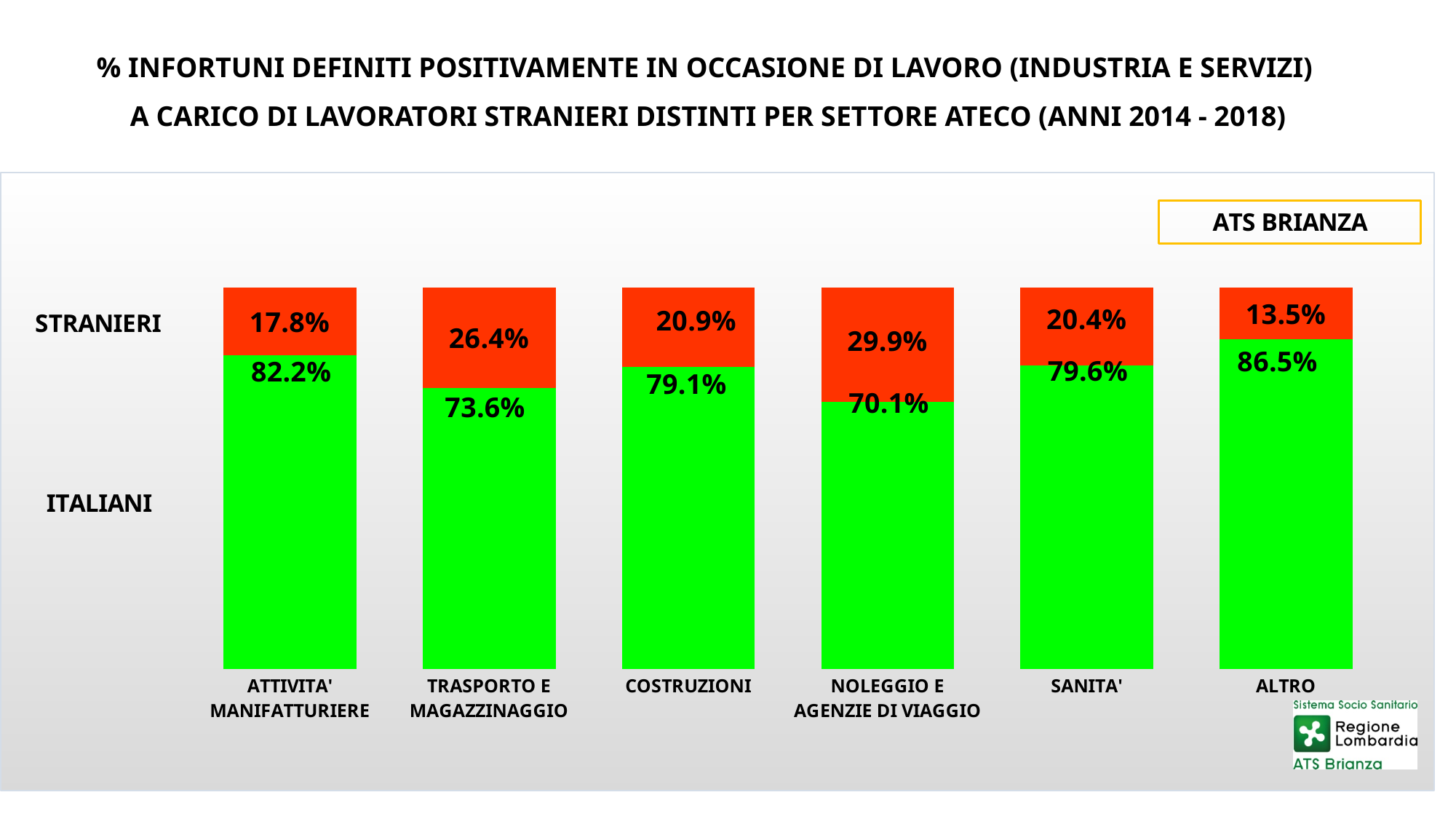
How many sectors are shown on the chart? 6 Which colour represents the STRANIERI segment of each bar? Red Which sector has the highest STRANIERI share? NOLEGGIO E AGENZIE DI VIAGGIO Is the STRANIERI share larger for COSTRUZIONI or for SANITA'? COSTRUZIONI What is the ITALIANI share for ALTRO? 86.5% What is the STRANIERI share for NOLEGGIO E AGENZIE DI VIAGGIO? 29.9% Which sector has the lowest STRANIERI share? ALTRO What is the difference between the STRANIERI shares for TRASPORTO E MAGAZZINAGGIO and ATTIVITA' MANIFATTURIERE? 8.6% What is the ITALIANI share for TRASPORTO E MAGAZZINAGGIO? 73.6% What kind of chart is shown? Stacked bar chart What is the STRANIERI share for SANITA'? 20.4% Which sector has the highest ITALIANI share? ALTRO